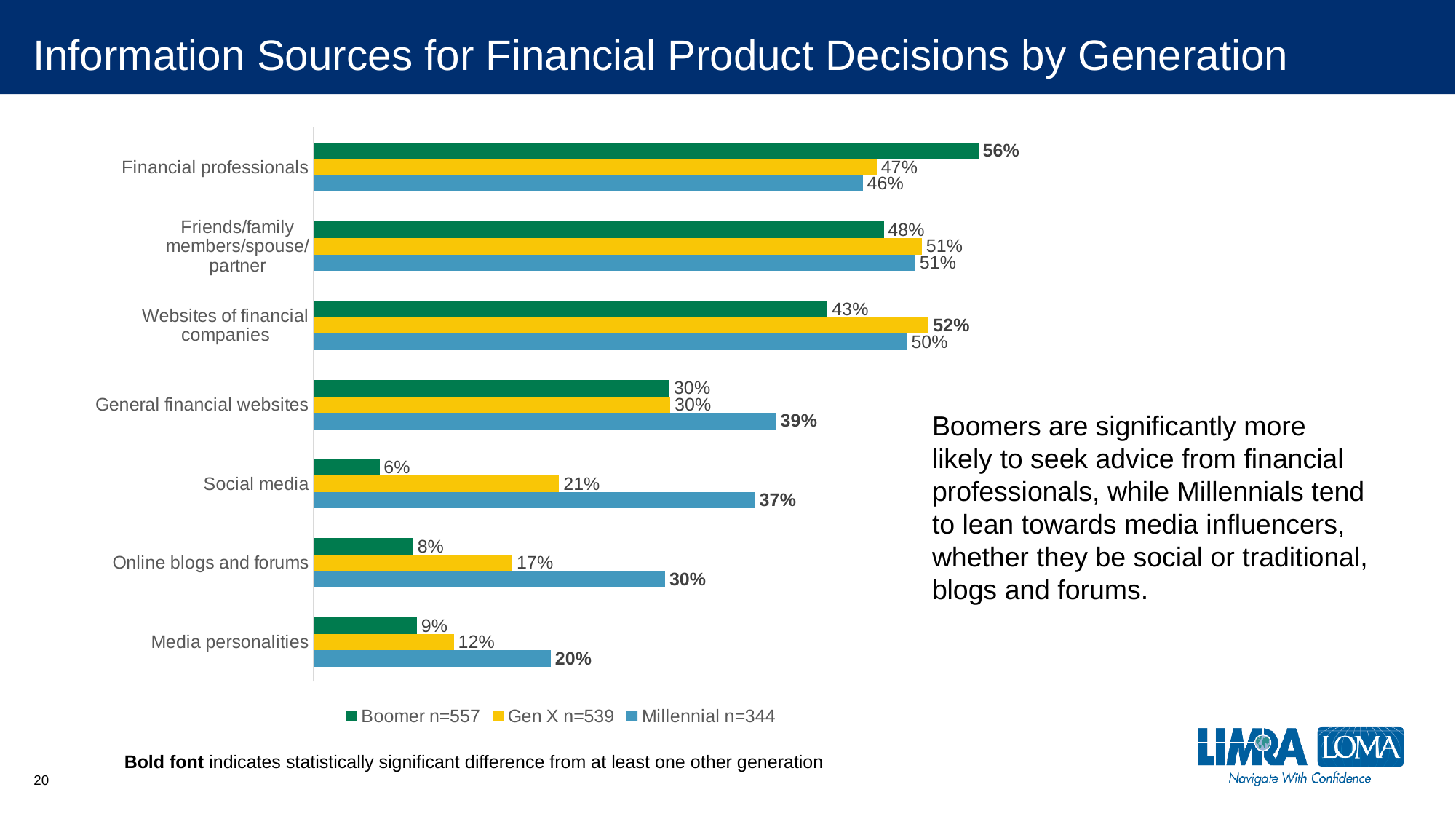
What kind of chart is shown on the slide? Bar chart What is the Gen X value for Websites of financial companies? 52% What is the difference between the Millennial and Boomer values for Social media? 31% Which is larger for Online blogs and forums: the Gen X value or the Millennial value? Millennial How many categories are shown on the chart? 7 How many series does the legend list? 3 What is the sample size for the Gen X series shown in the legend? n=539 What is the difference between the Boomer and Millennial values for Media personalities? 11% What is the Boomer value for Financial professionals? 56% Which category has the highest Millennial value? Friends/family members/spouse/partner What is the Millennial value for Social media? 37% Which category has the lowest Boomer value? Social media